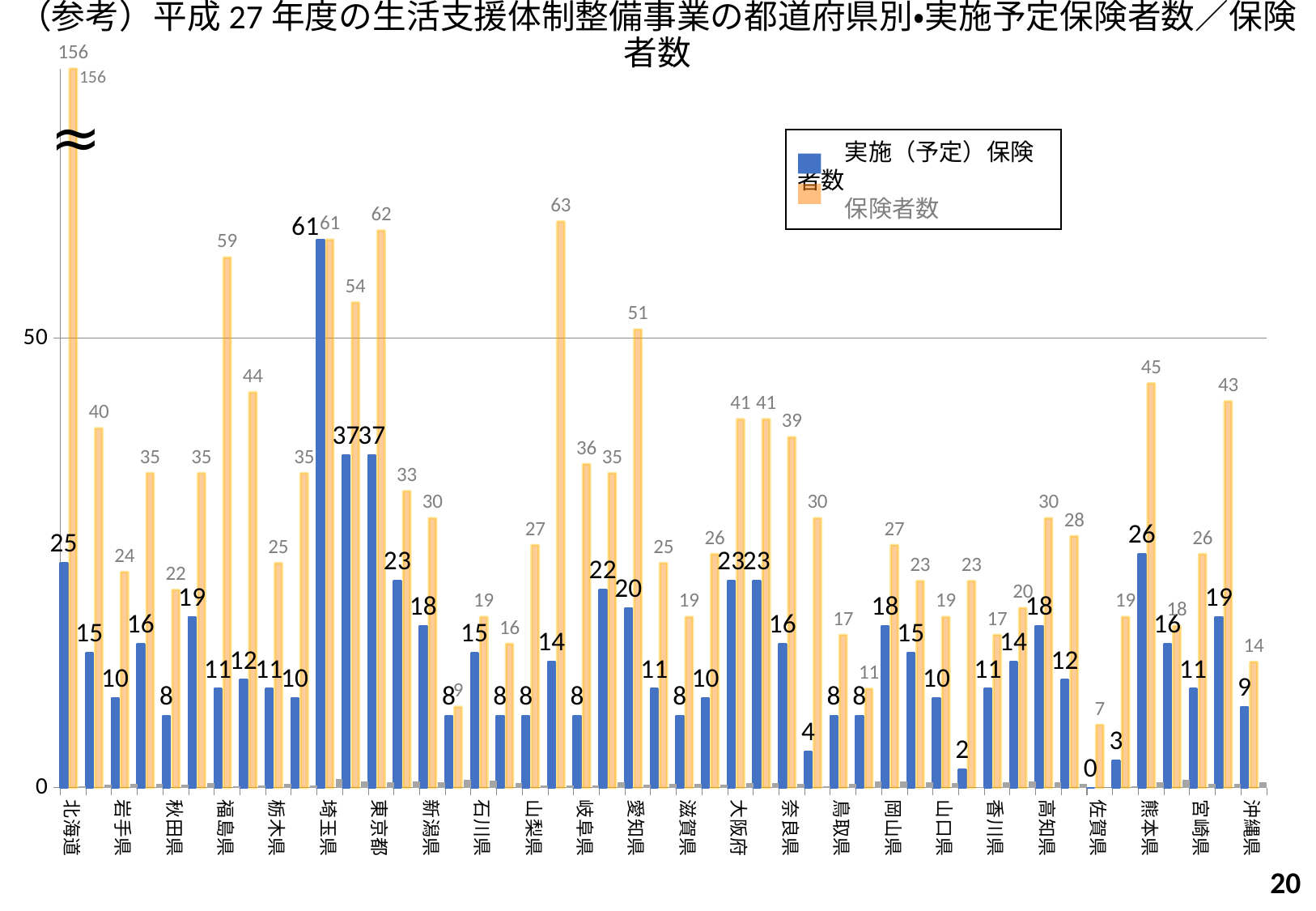
What is the 実施（予定）保険者数 value for 大阪府? 23 Is the 保険者数 value for 愛知県 greater or less than 50? greater What is the 保険者数 value for 東京都? 62 Which has a larger 実施（予定）保険者数 value, 熊本県 or 奈良県? 熊本県 Which labelled prefecture has the lowest 実施（予定）保険者数 value? 佐賀県 What type of chart is shown on the slide? bar chart What is the 実施（予定）保険者数 value for 埼玉県? 61 Which labelled prefecture has the highest 保険者数 value? 北海道 What is the difference between the 保険者数 and the 実施（予定）保険者数 for 福島県? 48 What is the 保険者数 value for 北海道? 156 How many series does the legend list? 2 What is the 実施（予定）保険者数 value for 佐賀県? 0